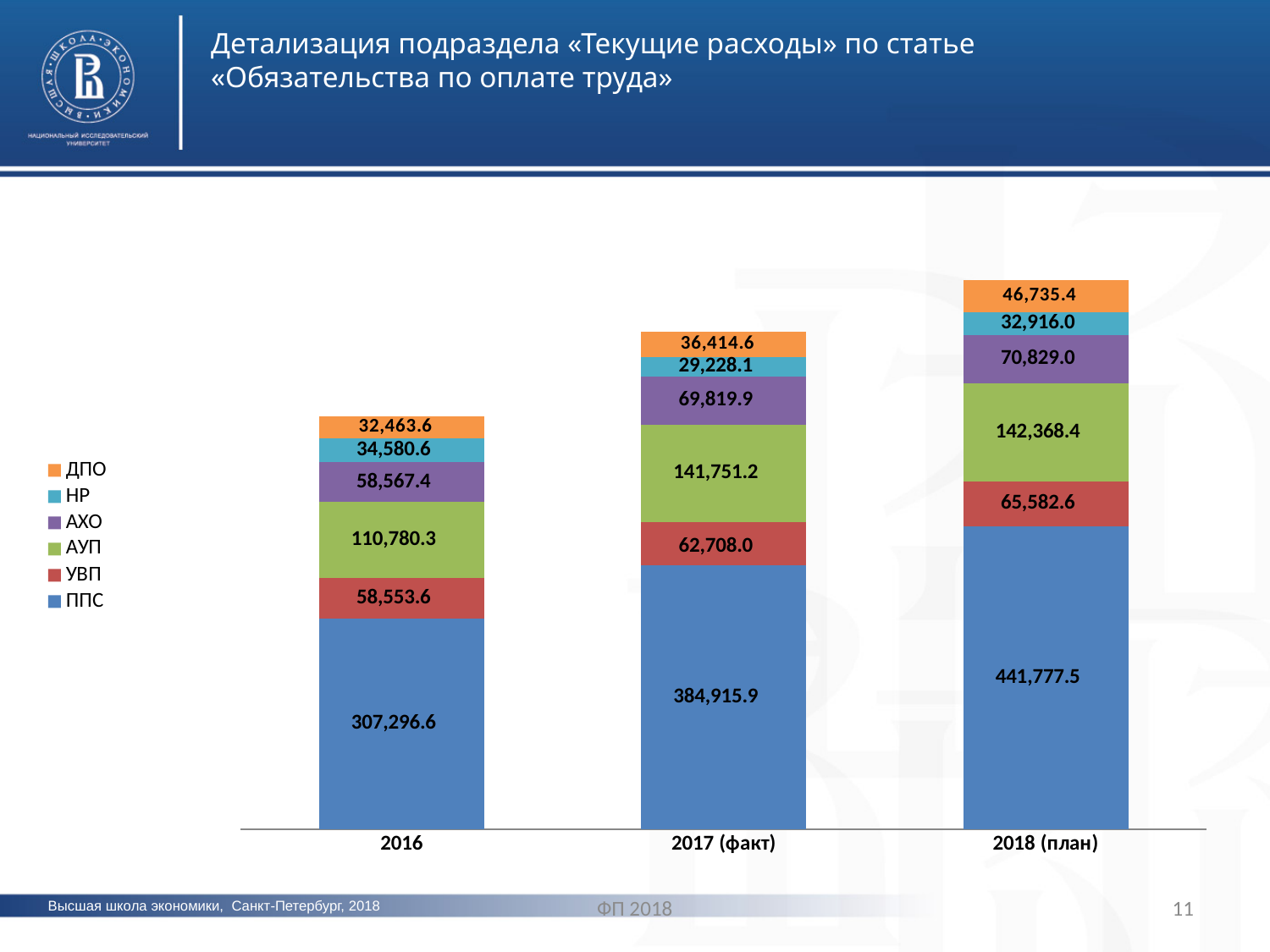
Which is larger: АХО in 2017 (факт) or АХО in 2018 (план)? АХО in 2018 (план) What is the value for НР in 2017 (факт)? 29,228.1 Which year has the lowest value for НР? 2017 (факт) What is the value for ППС in 2016? 307,296.6 How many categories are shown on the x axis? 3 Which year has the highest value for ППС? 2018 (план) What is the value for АУП in 2018 (план)? 142,368.4 How many series does the legend list? 6 What is the difference between the ППС values for 2018 (план) and 2016? 134,480.9 What is the value for ДПО in 2018 (план)? 46,735.4 What is the total of the stacked bar for 2016? 602,242.1 What kind of chart is shown on the slide? Stacked bar chart